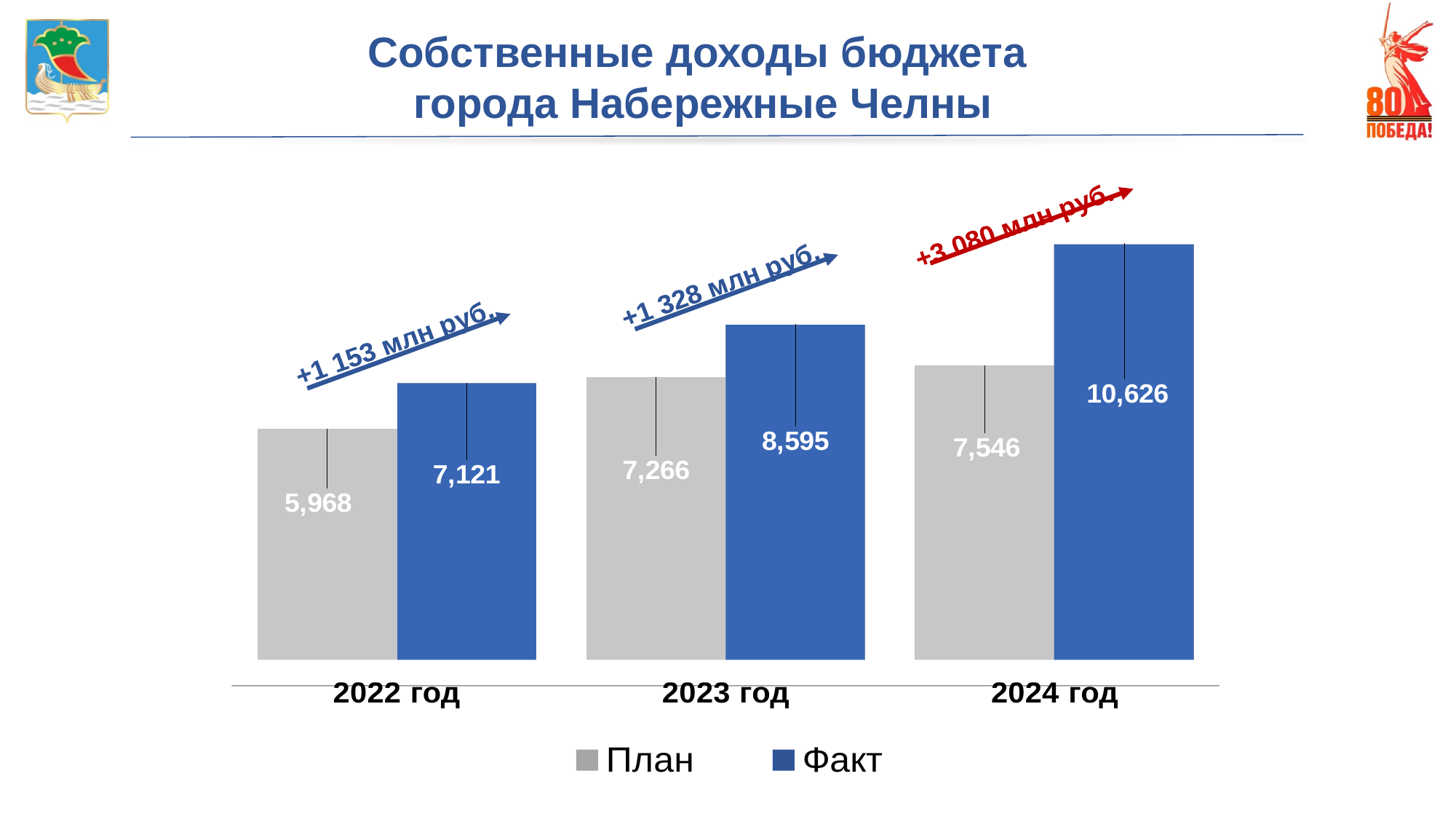
What is the difference between the Факт and План values for 2022 год? 1,153 What is the План value for 2024 год? 7,546 What is the План value for 2022 год? 5,968 How many series does the legend list? 2 What is the Факт value for 2024 год? 10,626 Which year has the highest Факт value? 2024 год What is the difference between the Факт and План values for 2024 год? 3,080 How many years are shown on the x axis? 3 Which year has the lowest План value? 2022 год What is the Факт value for 2023 год? 8,595 Which is larger, the План value for 2023 год or the Факт value for 2022 год? План value for 2023 год What kind of chart is shown on the slide? Bar chart